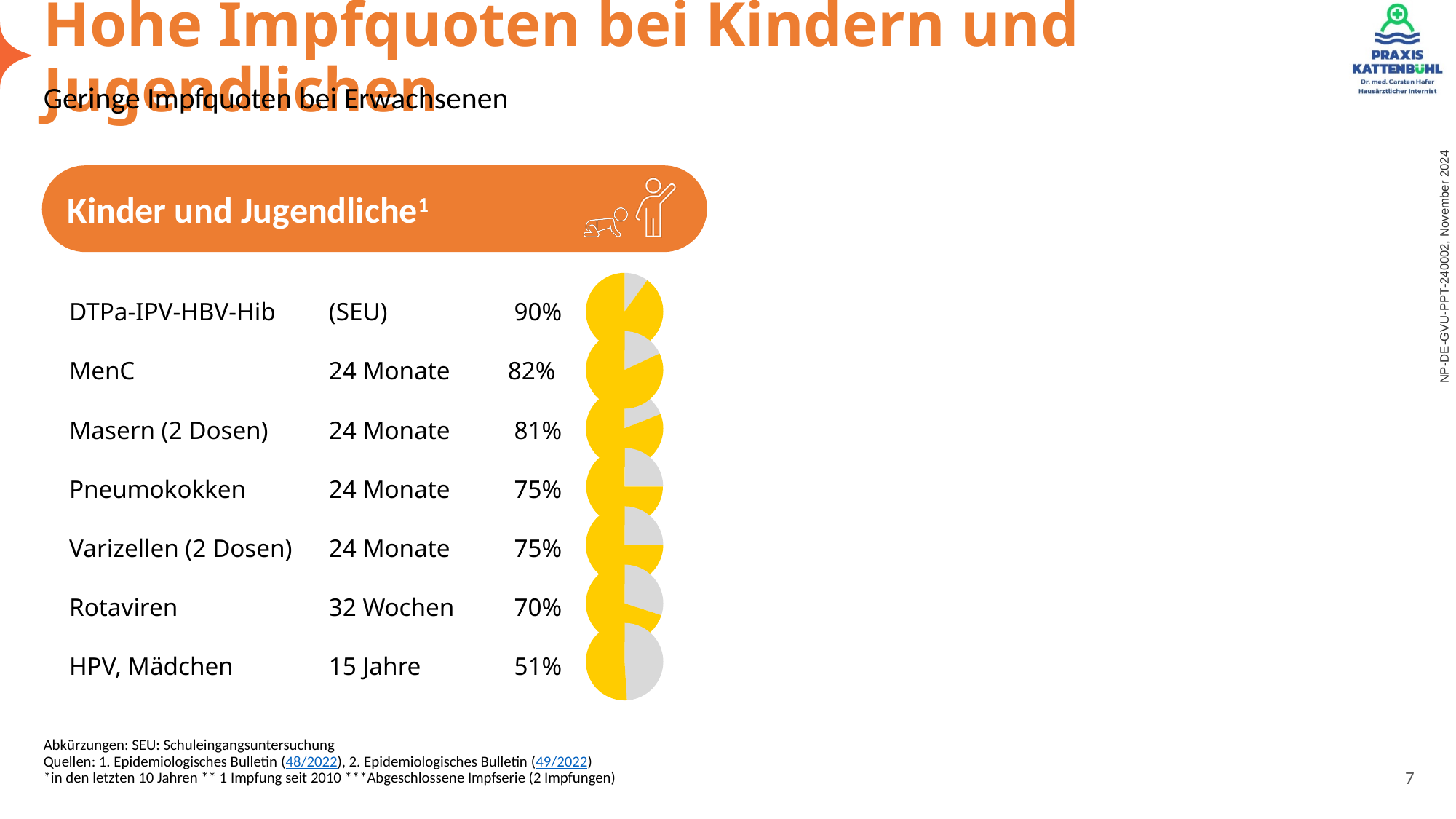
What is the vaccination rate shown for Rotaviren at 32 Wochen? 70% How many vaccinations are listed with a pie chart in the Kinder und Jugendliche section? 7 Which vaccination has the highest rate among the Kinder und Jugendliche rows? DTPa-IPV-HBV-Hib What colour represents the vaccinated share in the pie charts? Yellow What kind of chart is used to show each vaccination rate? Pie chart What is the difference between the vaccination rates for MenC and Rotaviren? 12% Which has a higher vaccination rate, Masern (2 Dosen) or Pneumokokken? Masern (2 Dosen) What is the vaccination rate shown for HPV, Mädchen at 15 Jahre? 51% What is the vaccination rate shown for DTPa-IPV-HBV-Hib? 90% Which vaccination has the lowest rate among the Kinder und Jugendliche rows? HPV, Mädchen What is the difference between the vaccination rates for DTPa-IPV-HBV-Hib and HPV, Mädchen? 39% What is the vaccination rate shown for MenC at 24 Monate? 82%